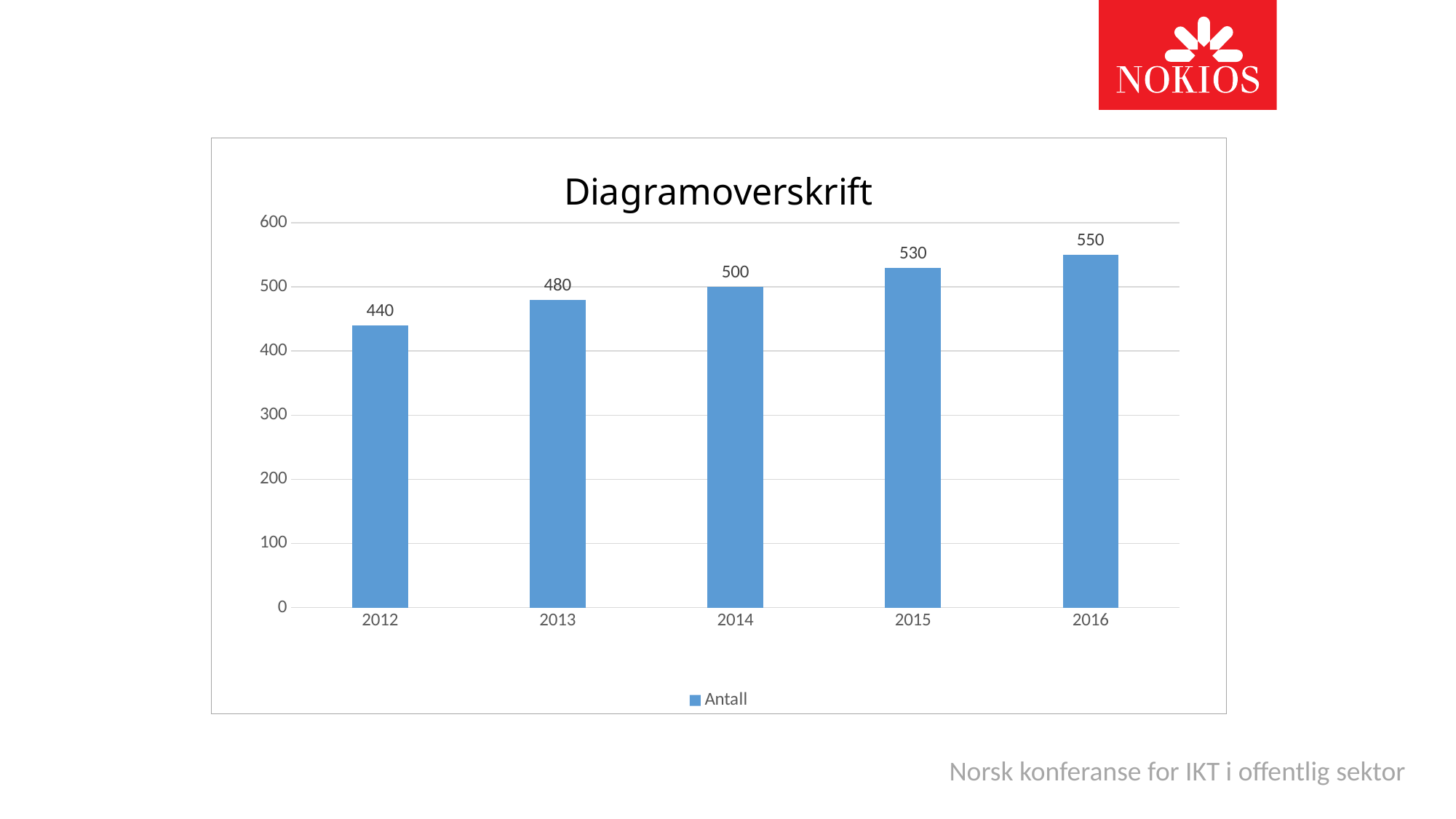
Which is larger, the value for 2013 or the value for 2015? 2015 What is the difference between the values for 2016 and 2012? 110 What is the value for 2012? 440 What is the value for 2014? 500 Is the value for 2015 greater or less than 500? greater What is the value for 2016? 550 How many years are shown on the x axis? 5 Which year has the highest value? 2016 What is the difference between the values for 2015 and 2013? 50 Do the values rise or fall from 2012 to 2016? Rise Which year has the lowest value? 2012 What kind of chart is shown on the slide? Bar chart